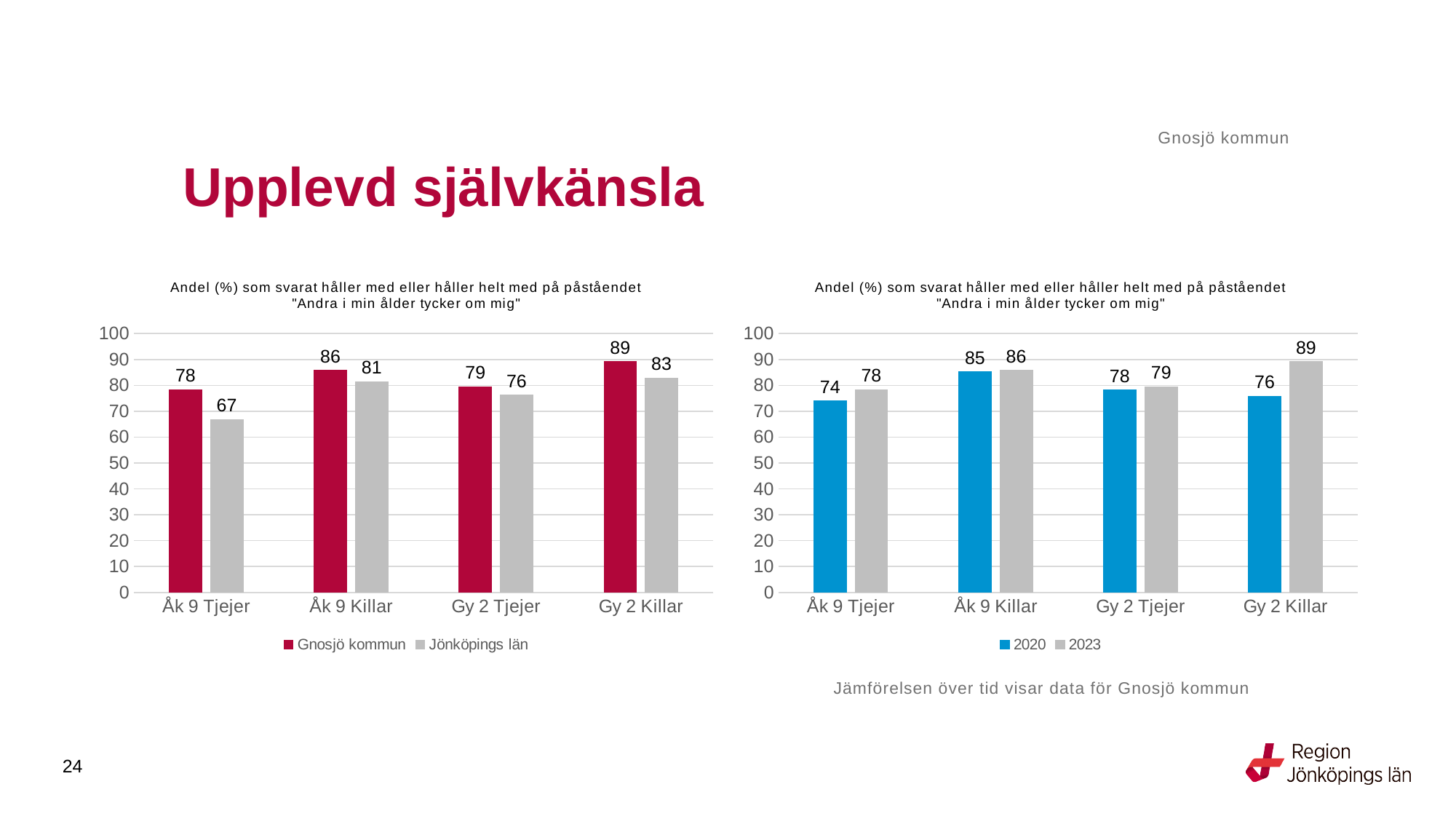
How many categories are shown on the x axis of the left chart? 4 In the left chart, what is the difference between Gnosjö kommun and Jönköpings län for Åk 9 Tjejer? 11 In the right chart, what is the difference between 2023 and 2020 for Gy 2 Killar? 13 In the left chart, what is the value for Gnosjö kommun for Åk 9 Tjejer? 78 In the left chart, which category has the highest value for Gnosjö kommun? Gy 2 Killar In the left chart, which category has the lowest value for Jönköpings län? Åk 9 Tjejer In the right chart, which is larger for Åk 9 Tjejer, the 2020 value or the 2023 value? 2023 In the right chart, what is the value for 2023 for Åk 9 Tjejer? 78 How many series does the legend of the right chart list? 2 In the left chart, what is the value for Jönköpings län for Gy 2 Killar? 83 In the right chart, what is the value for 2020 for Gy 2 Killar? 76 In the right chart, which category has the lowest value for 2020? Åk 9 Tjejer